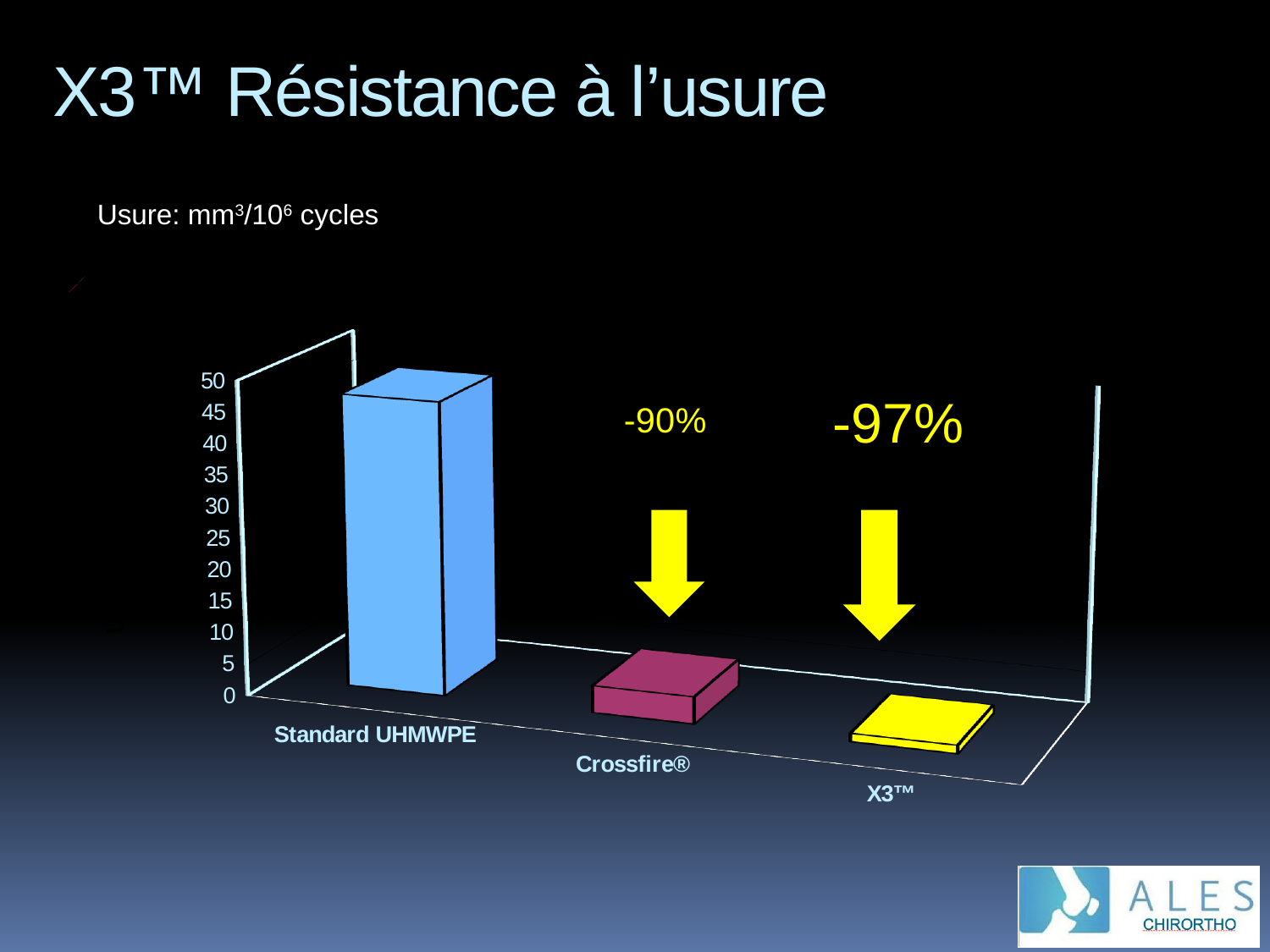
Is the value for Standard UHMWPE greater or less than 30? greater Is the value for Crossfire® greater or less than 15? less Which has a larger wear value, Crossfire® or X3™? Crossfire® Which has a larger wear value, Standard UHMWPE or Crossfire®? Standard UHMWPE What kind of chart is shown on the slide? bar chart Which category has the highest wear value? Standard UHMWPE What unit of wear is stated above the chart? mm³/10⁶ cycles What percentage reduction is annotated above the X3™ bar? -97% Which category has the lowest wear value? X3™ Is the value for X3™ greater or less than 10? less How many categories are plotted in the chart? 3